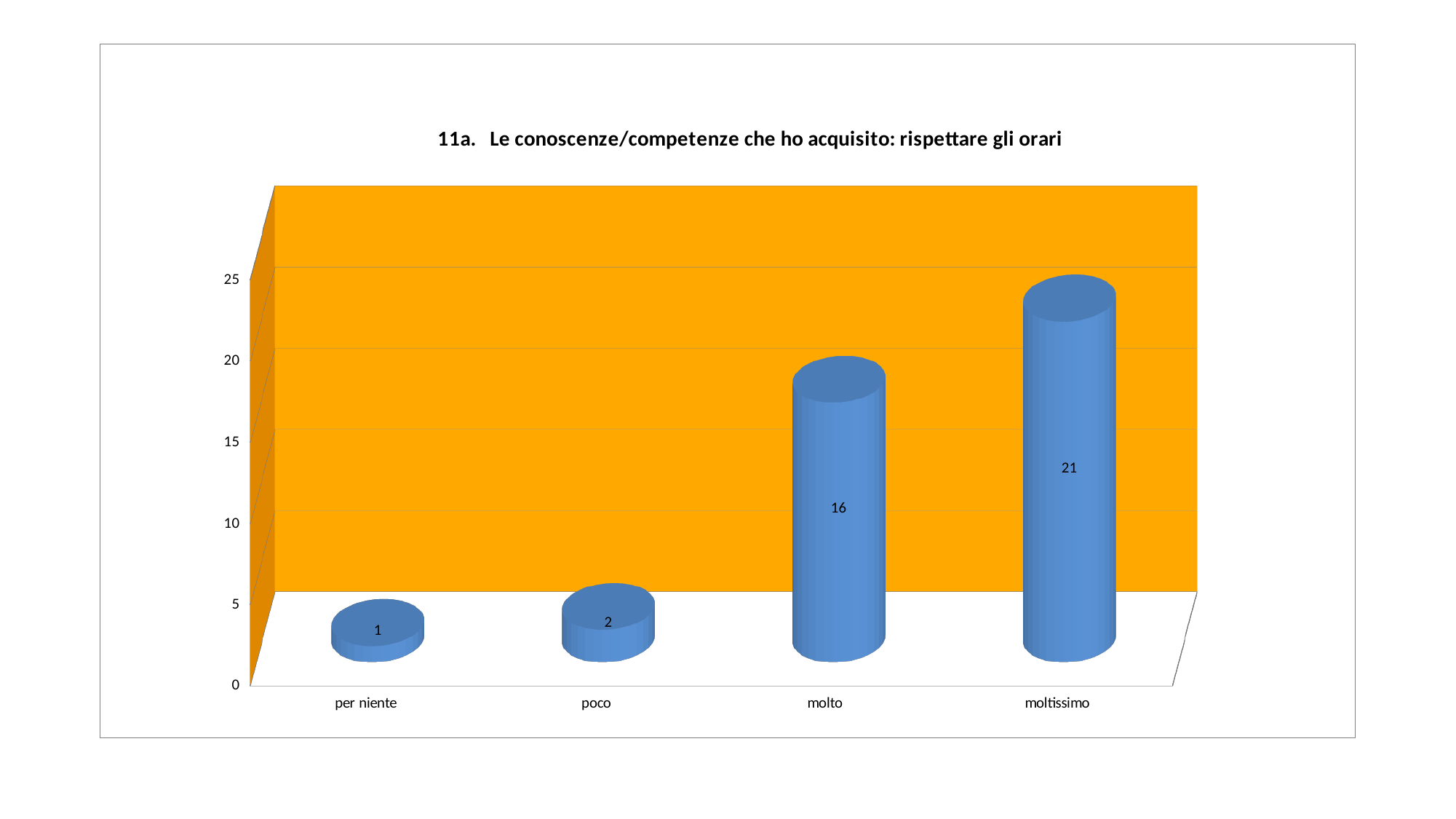
What is the value for "poco"? 2 What is the value for "molto"? 16 What is the difference between the values for "moltissimo" and "molto"? 5 How many categories are shown on the x axis? 4 What kind of chart is shown on the slide? bar chart Which category has the lowest value? per niente Do the values rise or fall from left to right along the x axis? rise Which category has the highest value? moltissimo What is the value for "moltissimo"? 21 Which is larger, the value for "poco" or the value for "molto"? molto What is the value for "per niente"? 1 What is the title of the chart? 11a. Le conoscenze/competenze che ho acquisito: rispettare gli orari